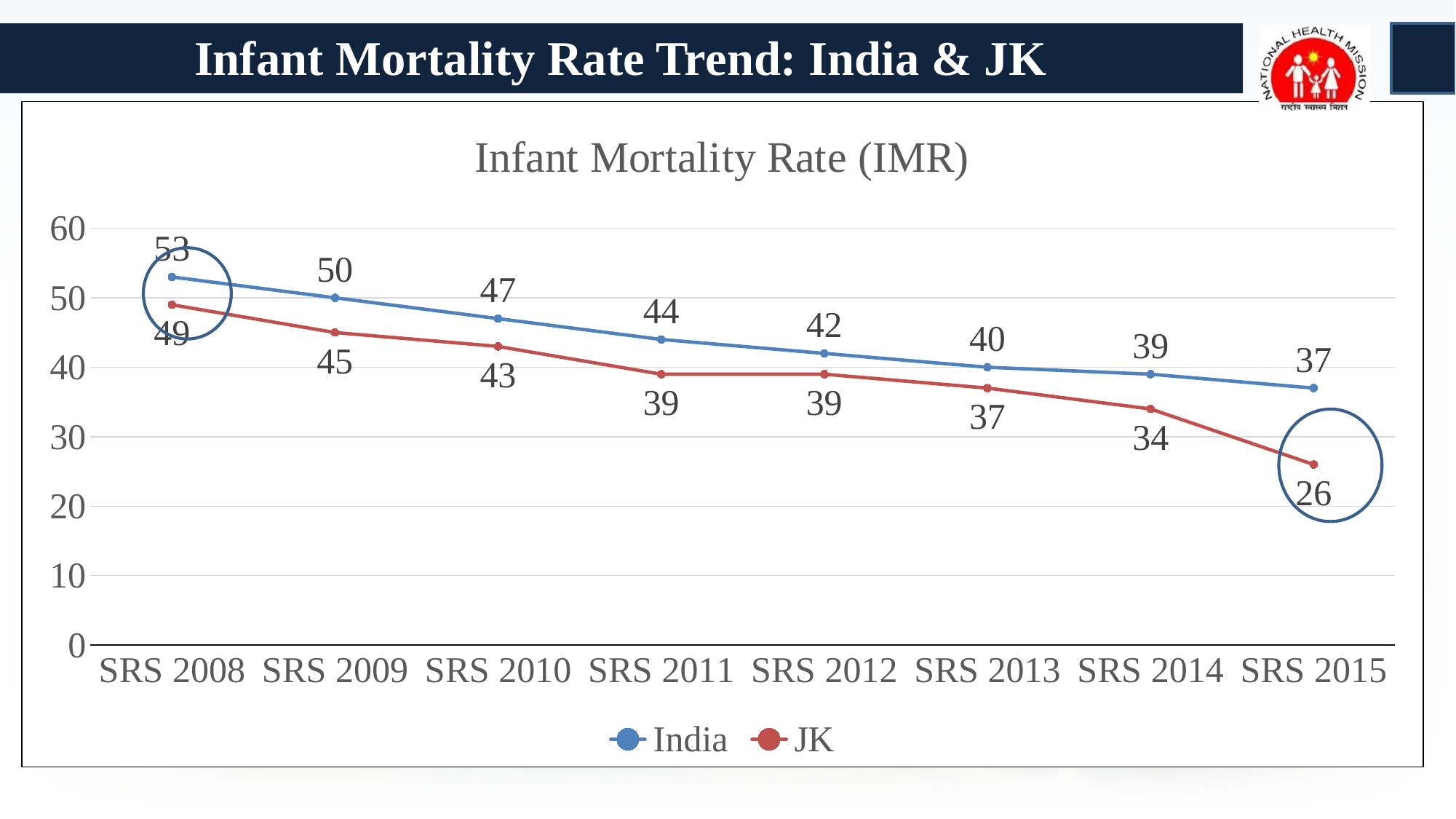
What is the IMR value for JK in SRS 2015? 26 What is the IMR value for India in SRS 2008? 53 How many series does the legend list? 2 What is the IMR value for JK in SRS 2011? 39 In which year is the India IMR value highest? SRS 2008 Do the JK IMR values rise or fall from SRS 2008 to SRS 2015? Fall In which year is the JK IMR value lowest? SRS 2015 What is the difference between the India and JK IMR values in SRS 2015? 11 Which series has the larger IMR value in SRS 2014, India or JK? India What is the IMR value for India in SRS 2013? 40 What kind of chart is shown on the slide? Line chart How many years (data points) are shown on the x axis? 8